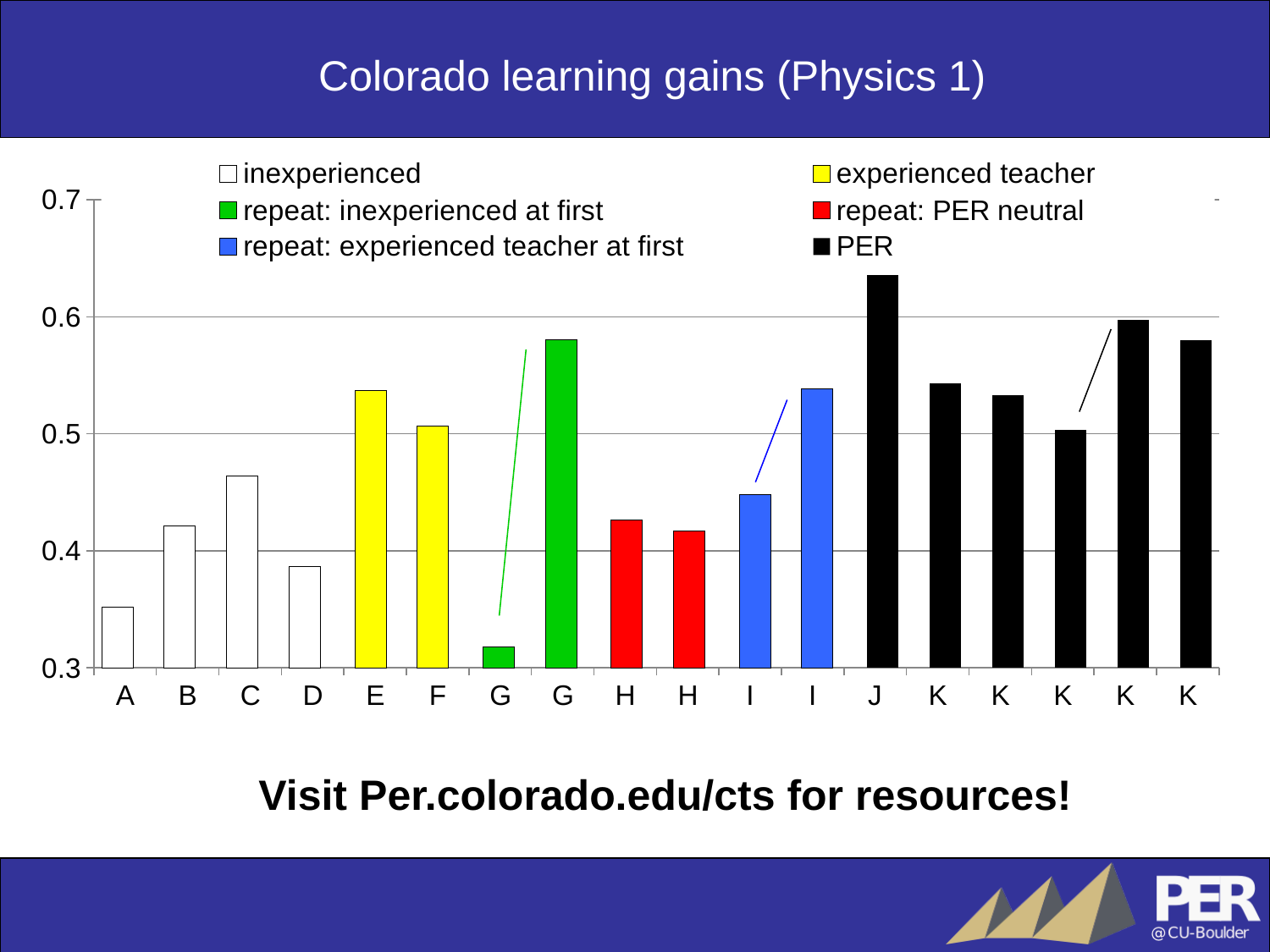
What kind of chart is shown on the slide? bar chart Is the value for A greater or less than 0.4? less Is the value for C greater or less than 0.4? greater How many bars are plotted in the chart? 18 Is the value for E greater or less than 0.5? greater Which category has the highest bar in the chart? J Which is larger, the value for E or the value for F? E How many series does the legend list? 6 What colour are the bars for the PER series? black Which is larger, the first I bar or the second I bar? the second I bar Which bar is the lowest in the chart? the first G bar